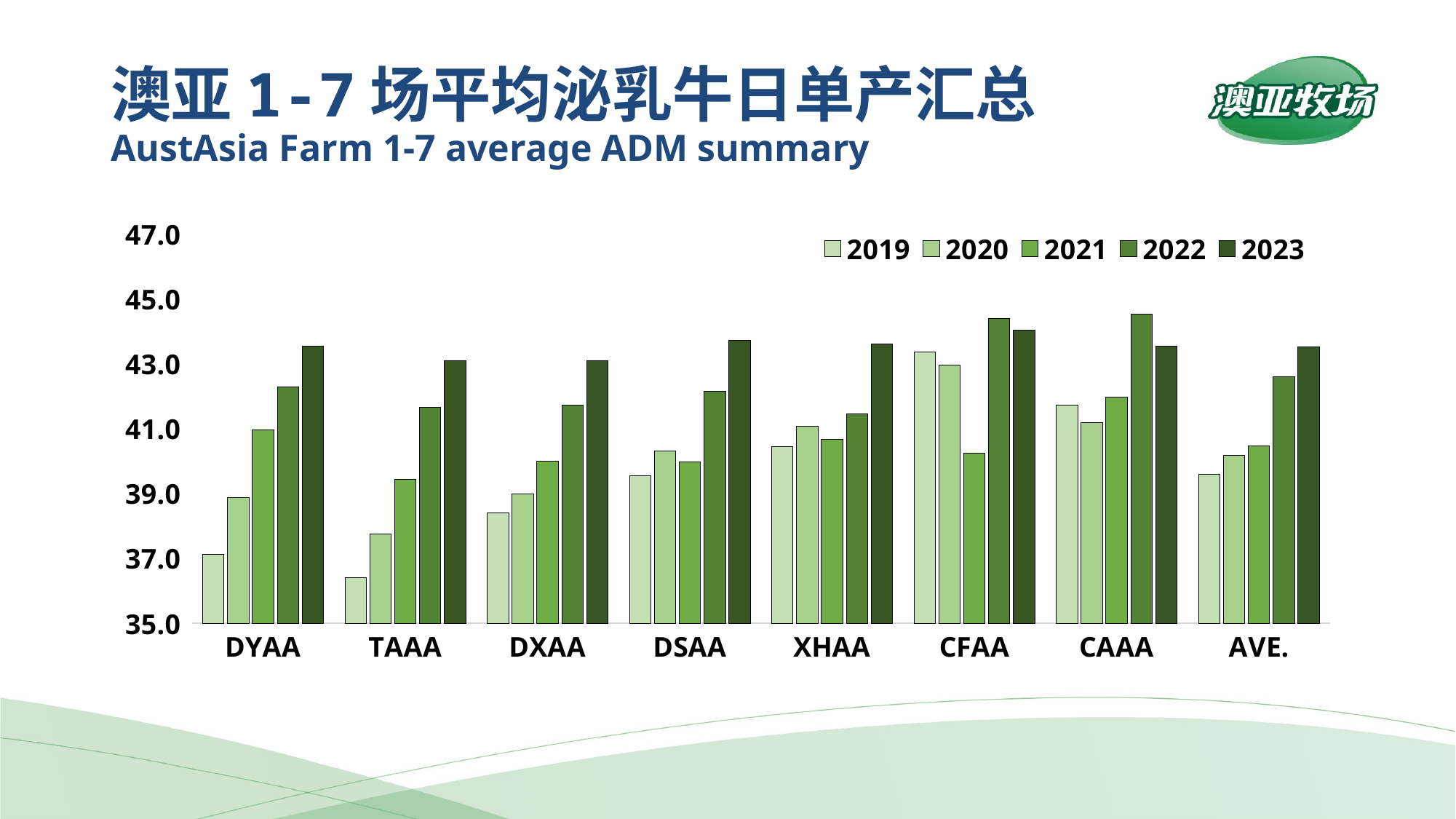
Which category has the lowest 2019 value? TAAA Which category has the highest 2019 value? CFAA What kind of chart is shown on the slide? bar chart Is the 2022 value for CFAA greater or less than 43.0? greater For TAAA, do the values rise or fall from 2019 to 2023? rise For DYAA, which is larger: the 2019 value or the 2023 value? 2023 Is the 2019 value for DYAA greater or less than 39.0? less How many categories are shown along the x axis? 8 For CFAA, which is larger: the 2020 value or the 2021 value? 2020 Is the 2019 value for TAAA greater or less than 37.0? less How many series does the legend list? 5 Which years are listed in the legend? 2019, 2020, 2021, 2022, 2023